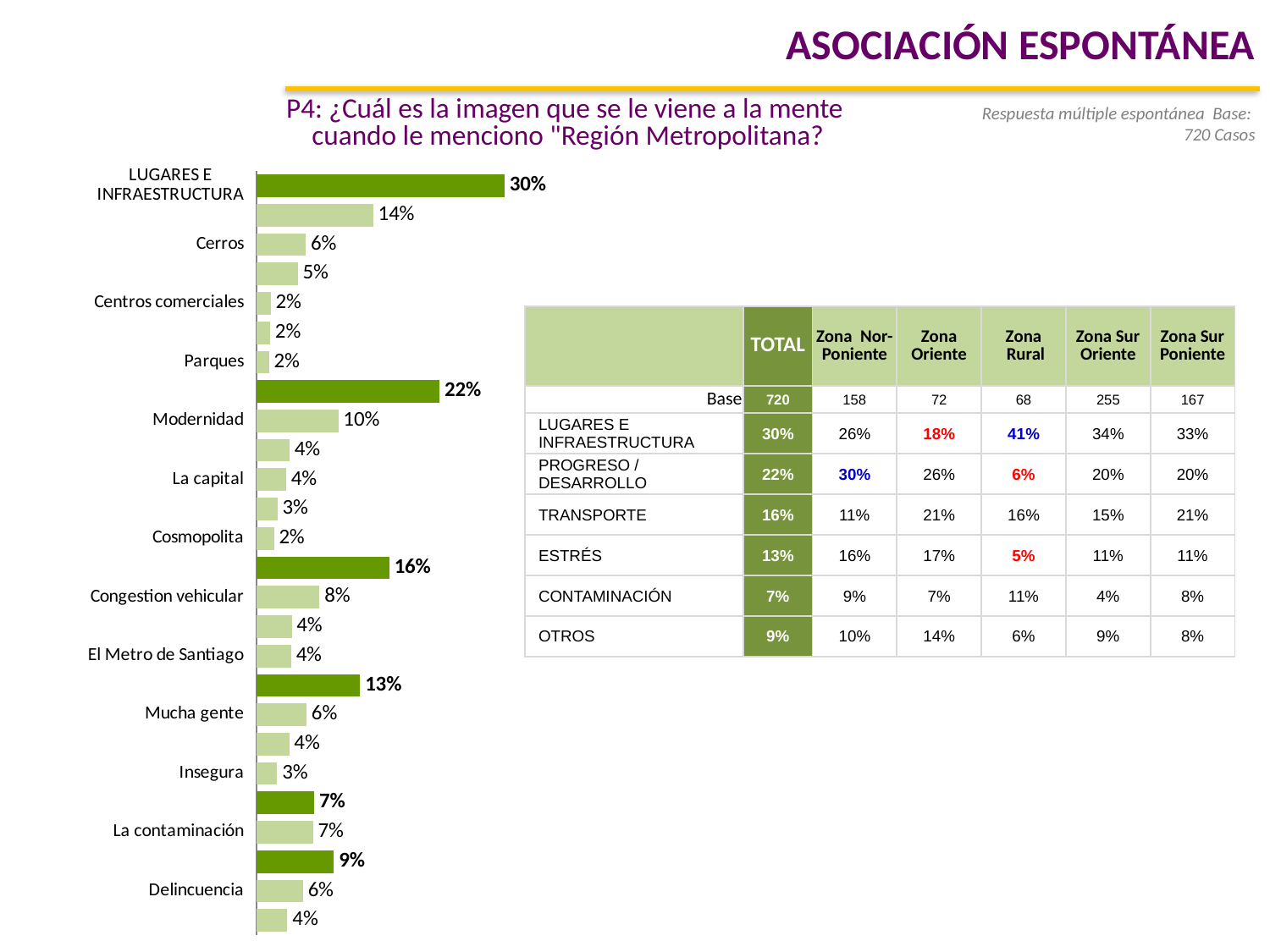
What is the value for Modernidad in the bar chart? 10% What is the value for Insegura in the bar chart? 3% What question is the chart on the slide based on? P4: ¿Cuál es la imagen que se le viene a la mente cuando le menciono "Región Metropolitana? Which is larger in the bar chart, Modernidad or Congestion vehicular? Modernidad What is the value for La contaminación in the bar chart? 7% Which labeled category has the highest value in the bar chart? LUGARES E INFRAESTRUCTURA What is the value for Congestion vehicular in the bar chart? 8% What kind of chart is shown on the slide? Bar chart What is the difference between the values for Modernidad and Congestion vehicular in the bar chart? 2 percentage points What is the value for Cerros in the bar chart? 6% What is the value for LUGARES E INFRAESTRUCTURA in the bar chart? 30% What is the difference between the values for LUGARES E INFRAESTRUCTURA and Delincuencia in the bar chart? 24 percentage points